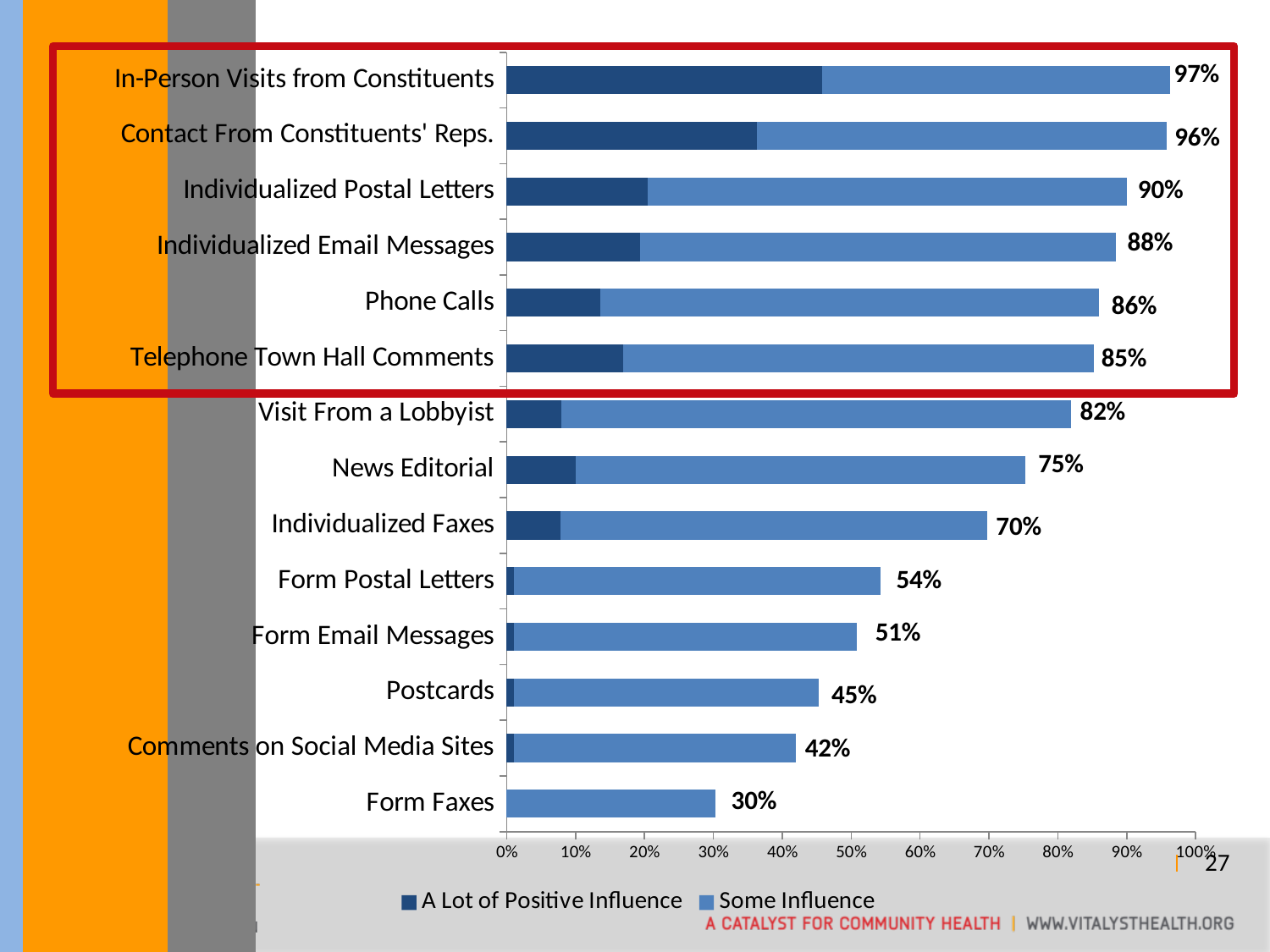
What is the difference between the total percentages for Individualized Postal Letters and Form Postal Letters? 36% What is the total percentage shown for Phone Calls? 86% Is the 'A Lot of Positive Influence' value for Phone Calls greater or less than 20%? less Which category has the lowest total percentage? Form Faxes What is the total percentage shown for In-Person Visits from Constituents? 97% How many categories are shown in the chart? 14 What is the total percentage shown for Form Faxes? 30% Which category has the highest total percentage? In-Person Visits from Constituents Which has a higher total percentage, News Editorial or Individualized Faxes? News Editorial What kind of chart is shown on the slide? Stacked bar chart How many series does the legend list? 2 Is the 'A Lot of Positive Influence' value for In-Person Visits from Constituents greater or less than 40%? greater